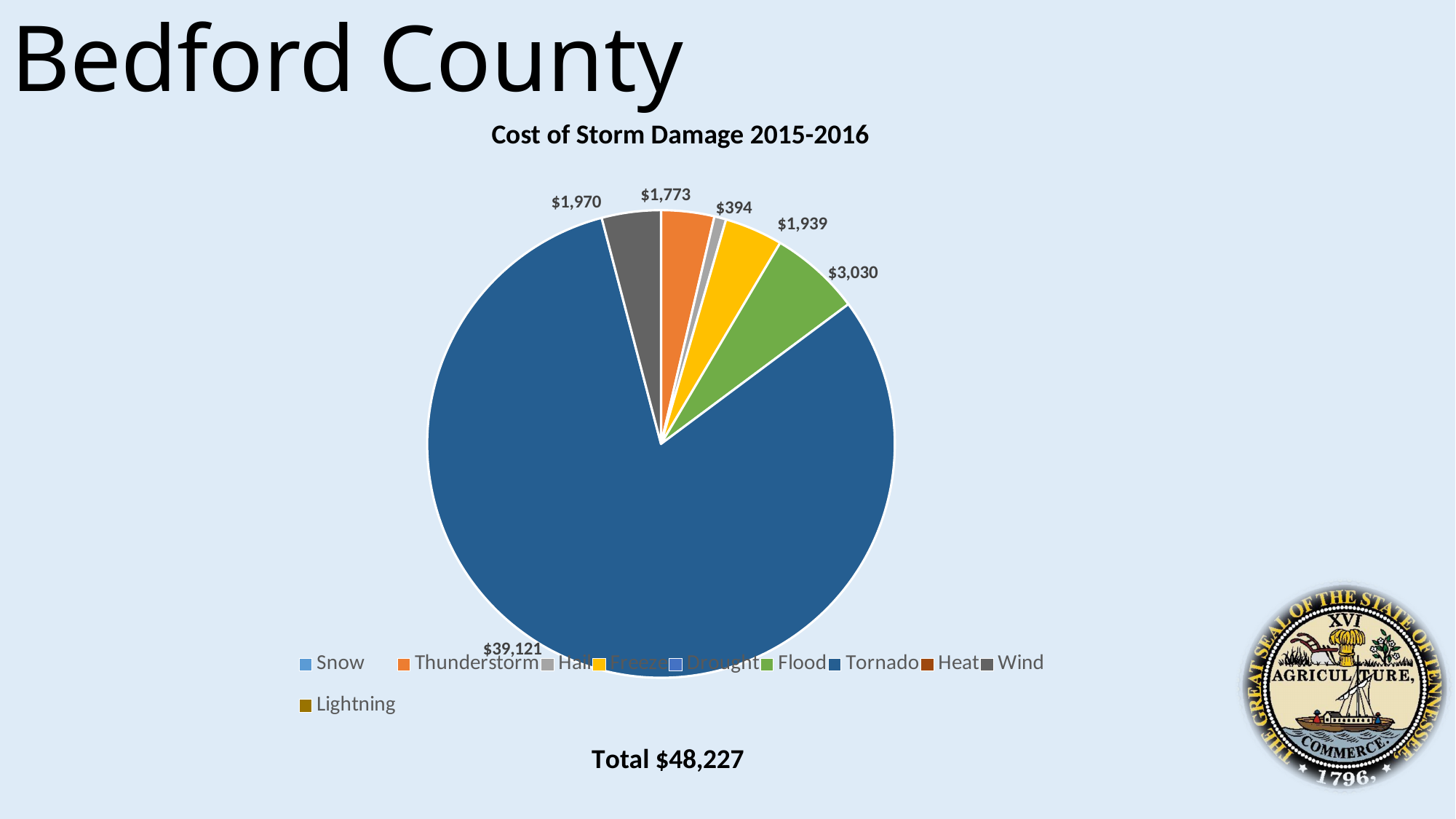
What is the cost of storm damage attributed to Flood? $3,030 Which is larger, the cost for Wind or the cost for Thunderstorm? Wind What total cost is printed below the chart? $48,227 What is the cost of storm damage attributed to Tornado? $39,121 How many entries does the legend list? 10 What is the difference between the Flood cost and the Freeze cost? $1,091 What is the cost of storm damage attributed to Wind? $1,970 Which storm type has the largest slice of the pie? Tornado What is the cost of storm damage attributed to Hail? $394 What type of chart is shown on the slide? Pie chart Which labelled slice has the smallest value? Hail What is the title of the chart? Cost of Storm Damage 2015-2016